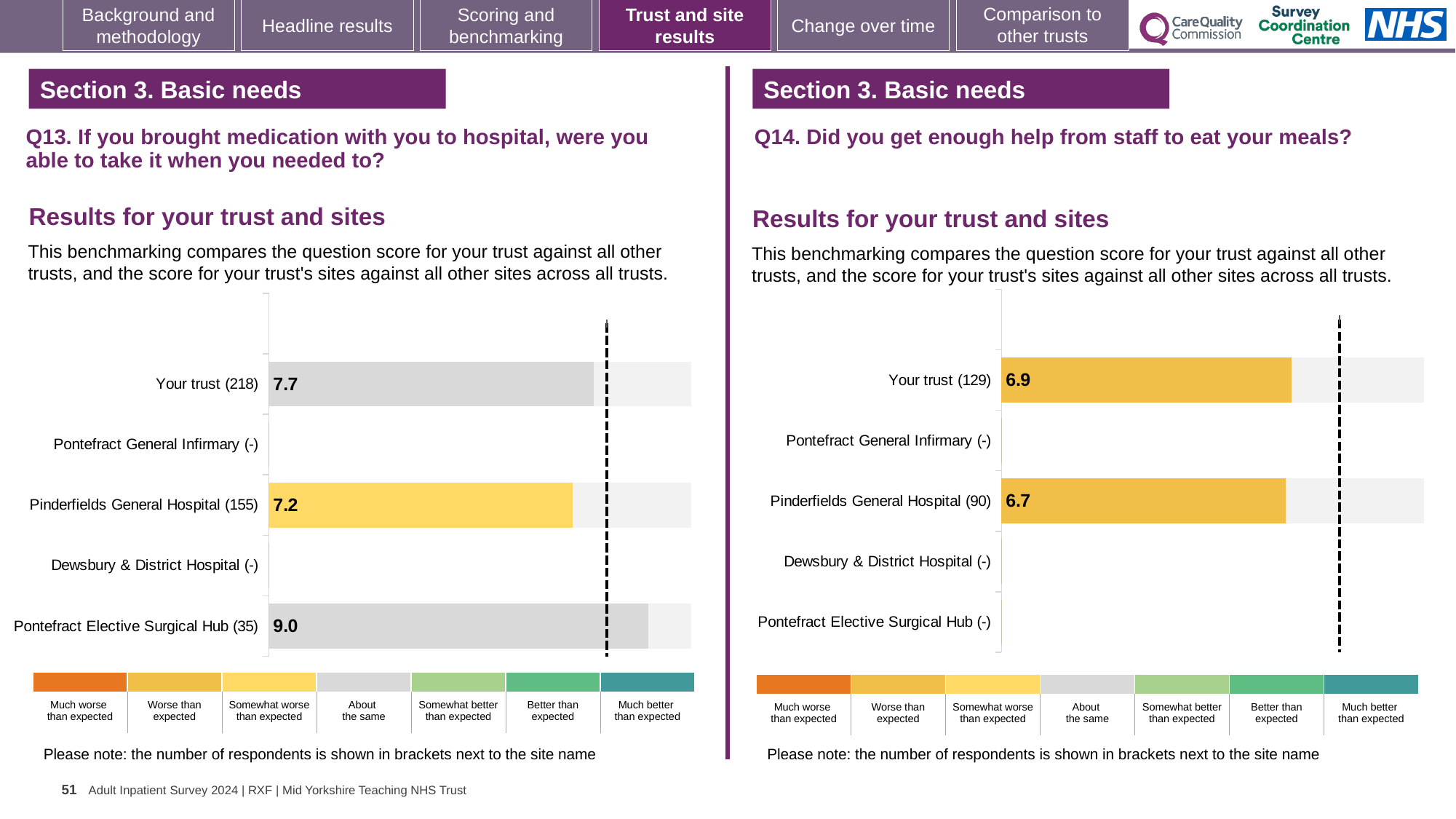
On the Q14 chart (right), how many site rows are listed below Your trust? 4 On the Q13 chart (left), how many respondents are shown for Your trust? 218 On the Q13 chart (left), what is the score for Your trust? 7.7 On the Q13 chart (left), which site has the highest score? Pontefract Elective Surgical Hub On the Q13 chart (left), what is the score for Pontefract Elective Surgical Hub? 9.0 What kind of chart is used on the Q13 chart (left)? Bar chart On the Q14 chart (right), what is the score for Pinderfields General Hospital? 6.7 On the Q14 chart (right), which is larger, the score for Your trust or for Pinderfields General Hospital? Your trust On the Q14 chart (right), what is the score for Your trust? 6.9 On the Q13 chart (left), what is the score for Pinderfields General Hospital? 7.2 On the Q14 chart (right), what is the difference between the scores for Your trust and Pinderfields General Hospital? 0.2 On the Q13 chart (left), what is the difference between the scores for Pontefract Elective Surgical Hub and Pinderfields General Hospital? 1.8